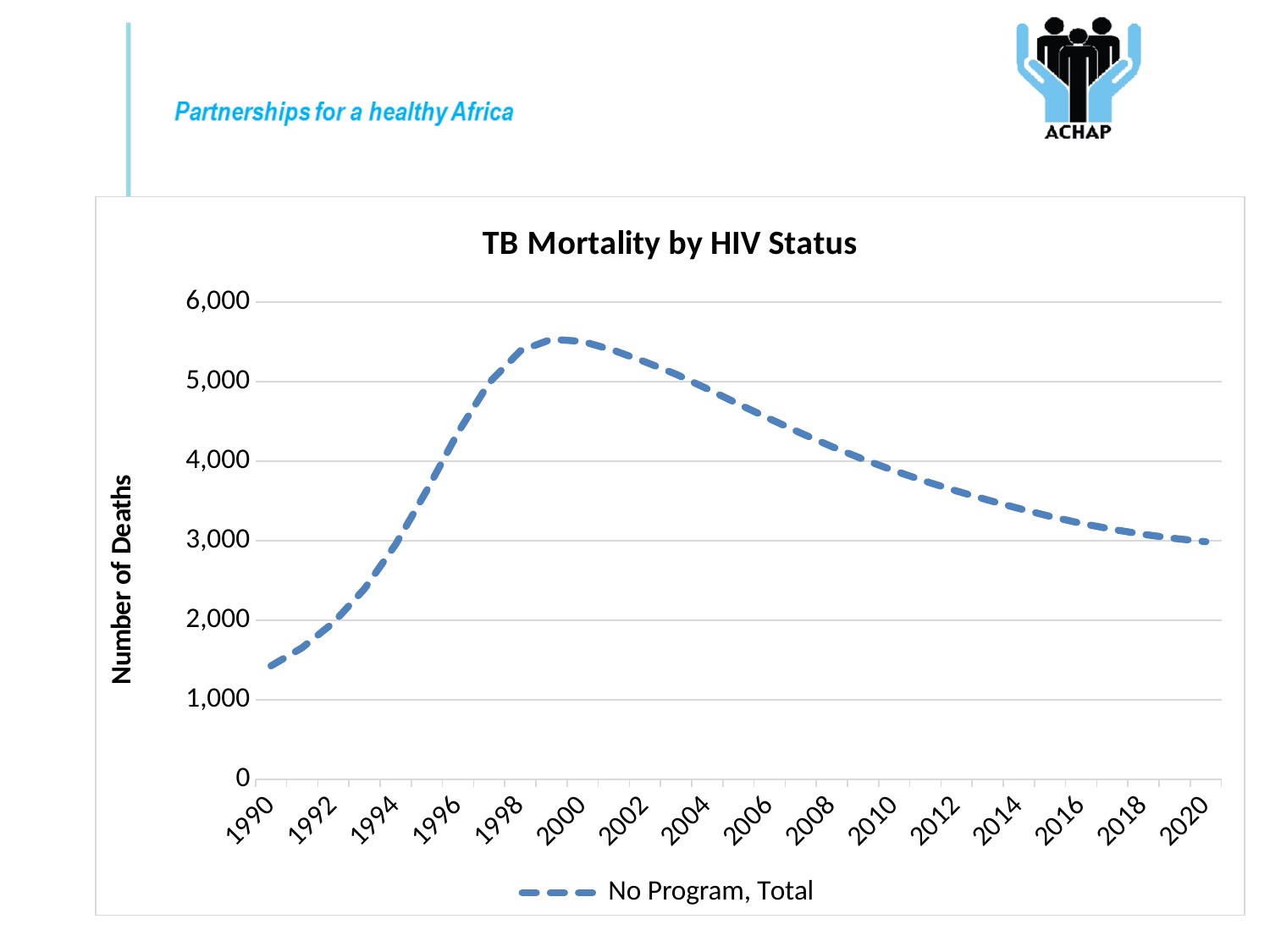
Which is larger, the value for 2000 or the value for 2020? 2000 Do the values rise or fall between 1990 and 1998? rise Is the value for 1990 greater or less than 2,000? less Which year has the lowest number of deaths? 1990 What is the title of the chart? TB Mortality by HIV Status What is the name of the series shown in the legend? No Program, Total What kind of chart is shown on the slide? line chart Is the value for 2008 greater or less than 5,000? less Do the values rise or fall between 2000 and 2020? fall Is the value for 2000 greater or less than 5,000? greater How many series does the legend list? 1